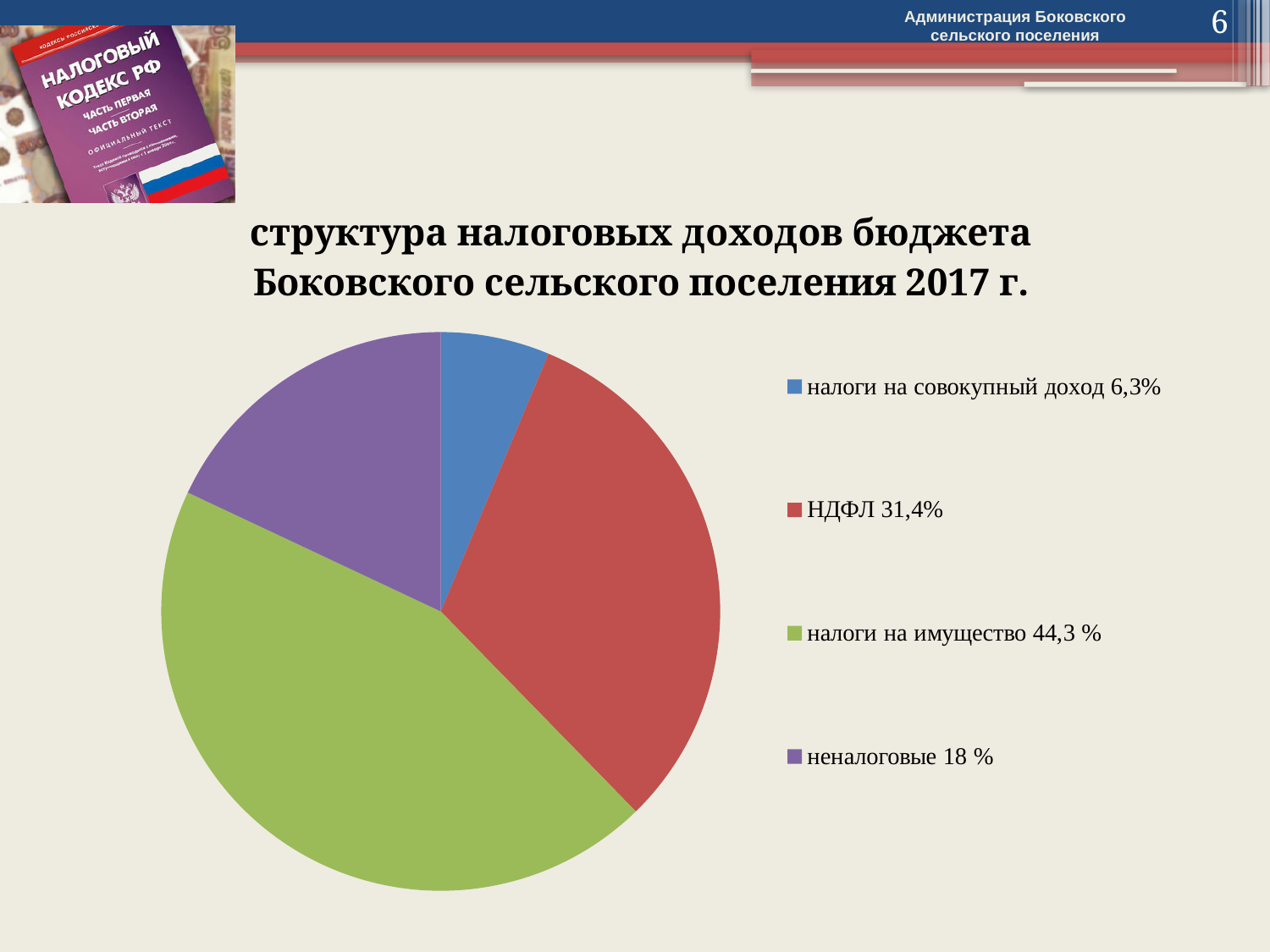
What colour is the slice for налоги на имущество? green What share of the pie does налоги на имущество have? 44,3 % Which is larger: the share for НДФЛ or the share for неналоговые? НДФЛ What is the difference between the share for налоги на имущество and the share for НДФЛ? 12,9% What share of the pie does НДФЛ have? 31,4% What is the difference between the share for неналоговые and the share for налоги на совокупный доход? 11,7% What share of the pie does неналоговые have? 18 % What share of the pie does налоги на совокупный доход have? 6,3% How many categories does the pie chart show? 4 Which category has the largest share of the pie? налоги на имущество Which category has the smallest share of the pie? налоги на совокупный доход What kind of chart is shown on the slide? pie chart